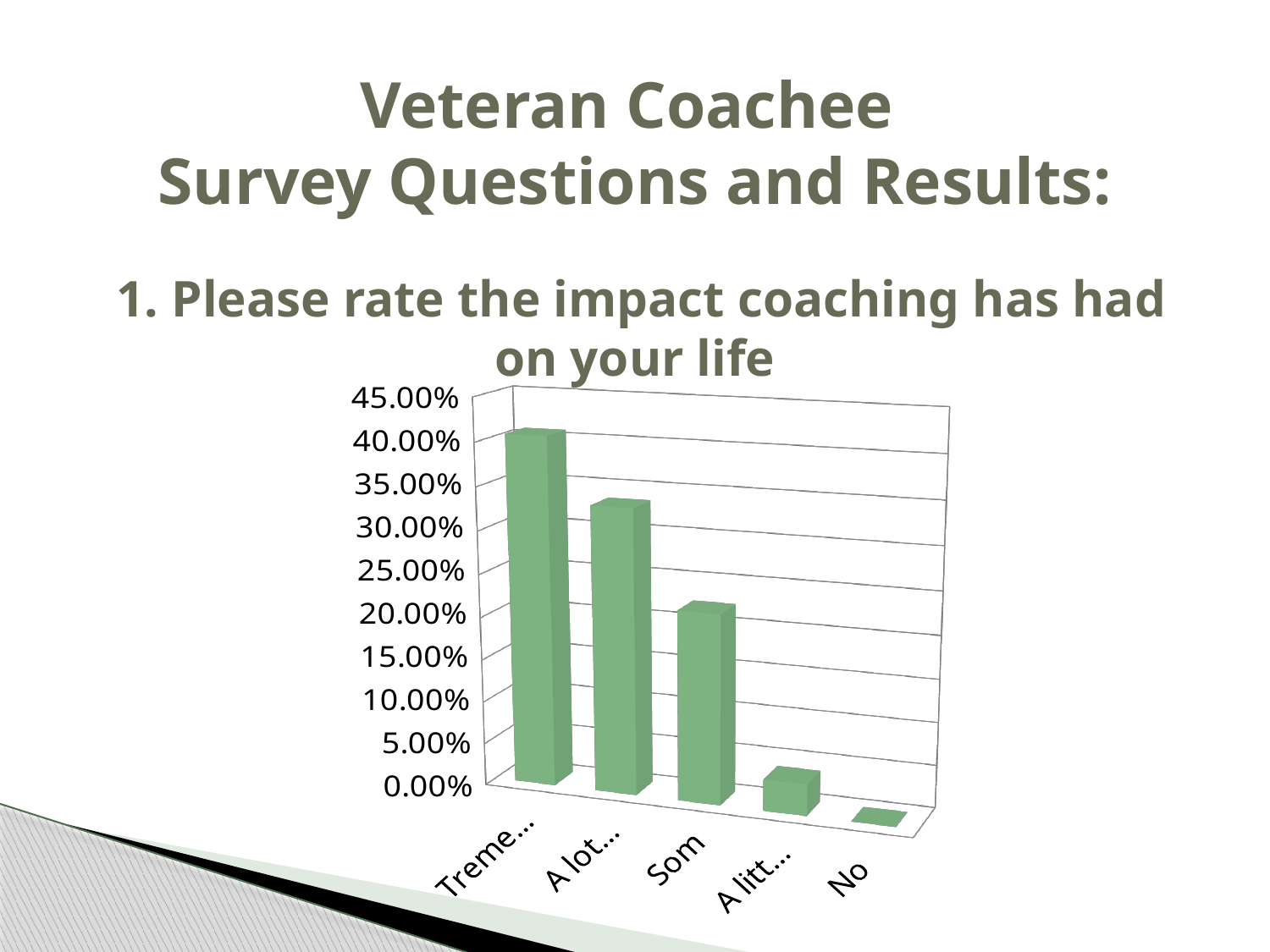
Which category has the highest bar in the chart? Treme... Which is larger, the value for "A lot..." or the value for "Som"? A lot... What kind of chart is shown on the slide? Bar chart Is the value for "Treme..." greater or less than 35.00%? greater What is the highest value shown on the chart's vertical axis? 45.00% Is the value for "A litt..." greater or less than 10.00%? less Which is larger, the value for "A litt..." or the value for "No"? A litt... Which category has the lowest bar in the chart? No What is the title of the chart? 1. Please rate the impact coaching has had on your life Is the value for "Som" greater or less than 25.00%? less Do the bar values rise or fall moving from left to right along the x axis? Fall How many categories are plotted on the x axis of the chart? 5